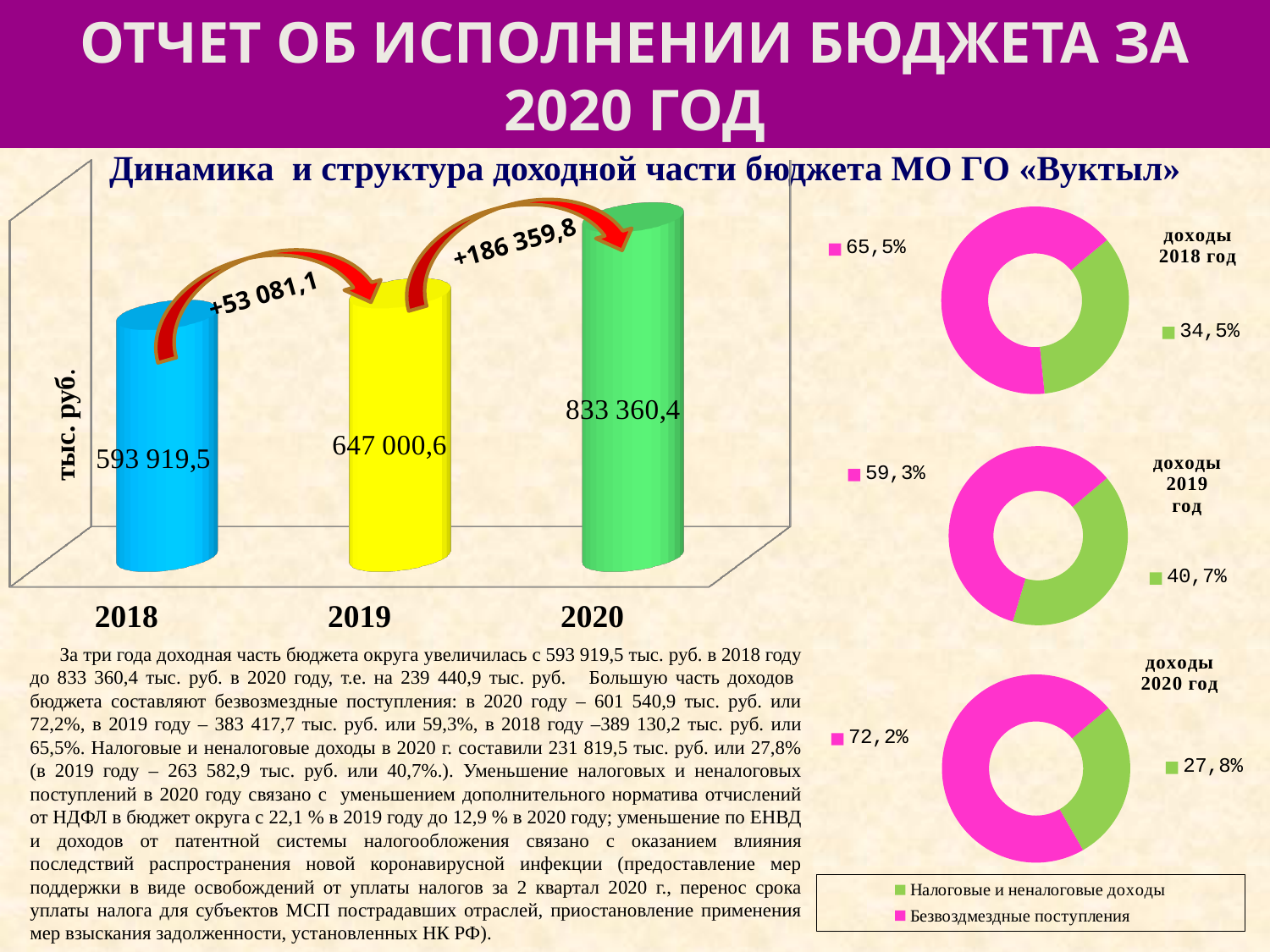
In the bar chart on the left, what is the value for 2018? 593 919,5 In the bar chart on the left, which year has the lowest value? 2018 In the bar chart on the left, which year has the highest value? 2020 In the donut chart titled 'доходы 2019 год', what share is Налоговые и неналоговые доходы? 40,7% In the bar chart on the left, what is the value for 2020? 833 360,4 In the bar chart on the left, what is the difference between the 2020 and 2019 values? 186 359,8 How many entries does the legend below the donut charts list? 2 In the donut chart titled 'доходы 2020 год', what share is Безвозмездные поступления? 72,2% What kind of chart is the chart on the left showing values for 2018, 2019 and 2020? bar chart In the bar chart on the left, do the values rise or fall from 2018 to 2020? rise In the bar chart on the left, how many years are shown? 3 In the donut chart titled 'доходы 2018 год', which is larger: Безвозмездные поступления or Налоговые и неналоговые доходы? Безвозмездные поступления